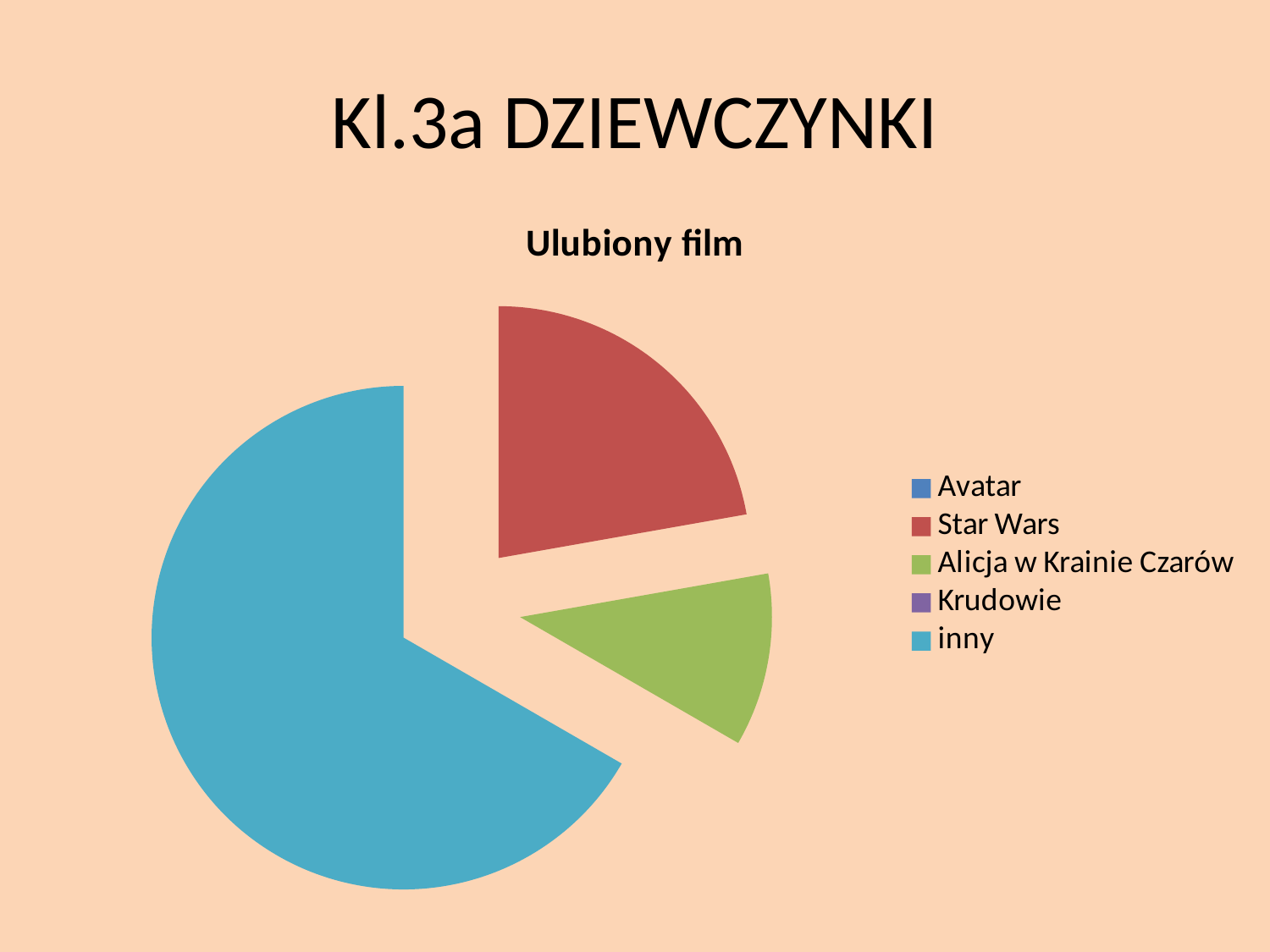
Which slice is larger, inny or Star Wars? inny What kind of chart is shown on the slide? pie chart Which category has the largest slice of the pie? inny What is the title of the chart? Ulubiony film Which slice is larger, inny or Alicja w Krainie Czarów? inny Which slice is larger, Star Wars or Alicja w Krainie Czarów? Star Wars Which category is shown in red in the legend? Star Wars How many slices are visible in the pie? 3 Of the slices visible in the pie, which is the smallest? Alicja w Krainie Czarów How many entries does the chart legend list? 5